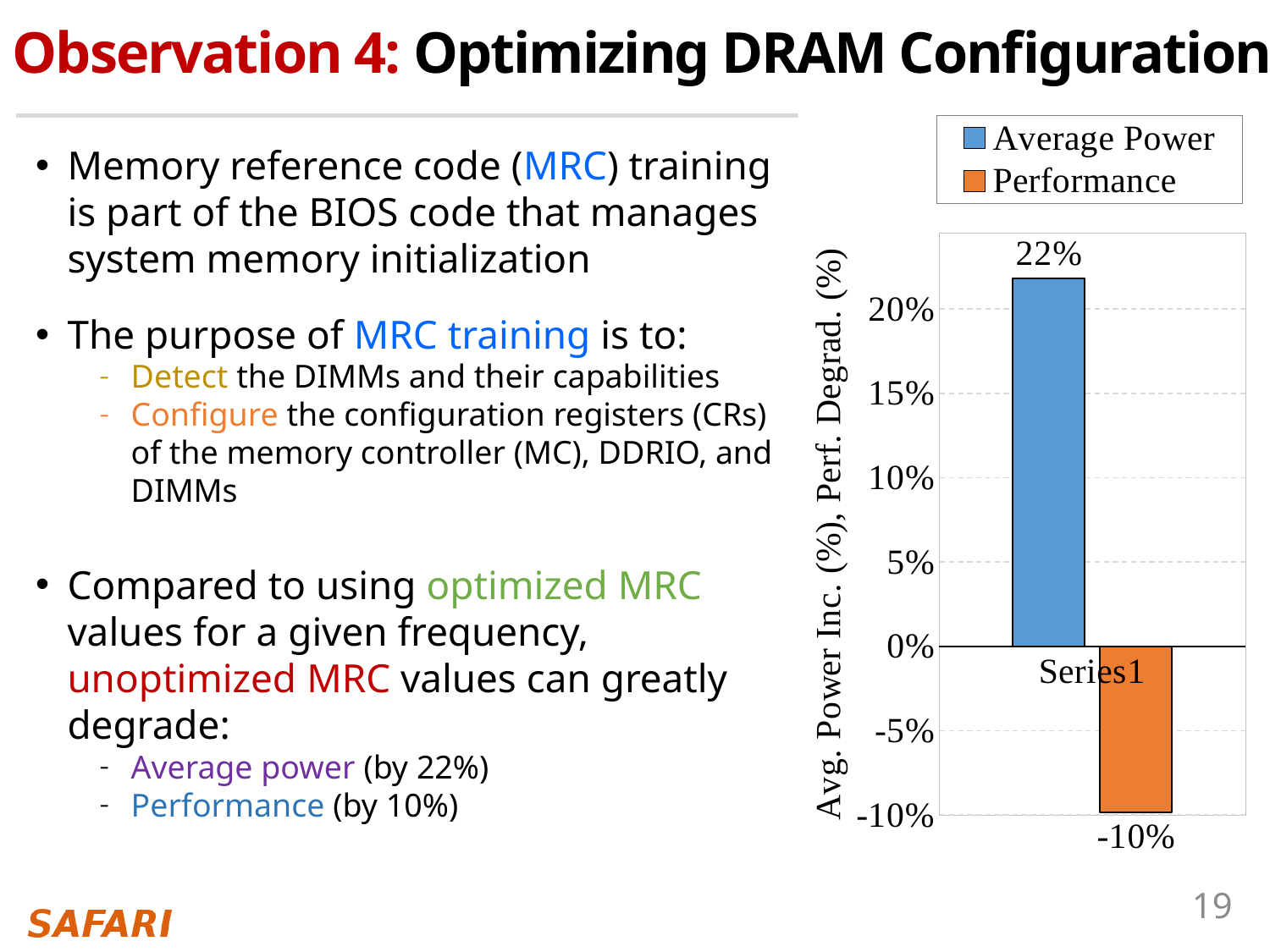
What is the value of the Average Power bar? 22% What is the category label shown on the x axis of the chart? Series1 What colour is the Performance bar? Orange Which series has the higher value, Average Power or Performance? Average Power What is the label of the vertical axis? Avg. Power Inc. (%), Perf. Degrad. (%) What is the difference between the Average Power value and the Performance value? 32 percentage points What is the value of the Performance bar? -10% Is the value for Average Power greater or less than 20%? greater Is the value for Performance greater or less than 0%? less What kind of chart is shown on the slide? Bar chart Which series has the lowest value in the chart? Performance How many series does the legend list? 2